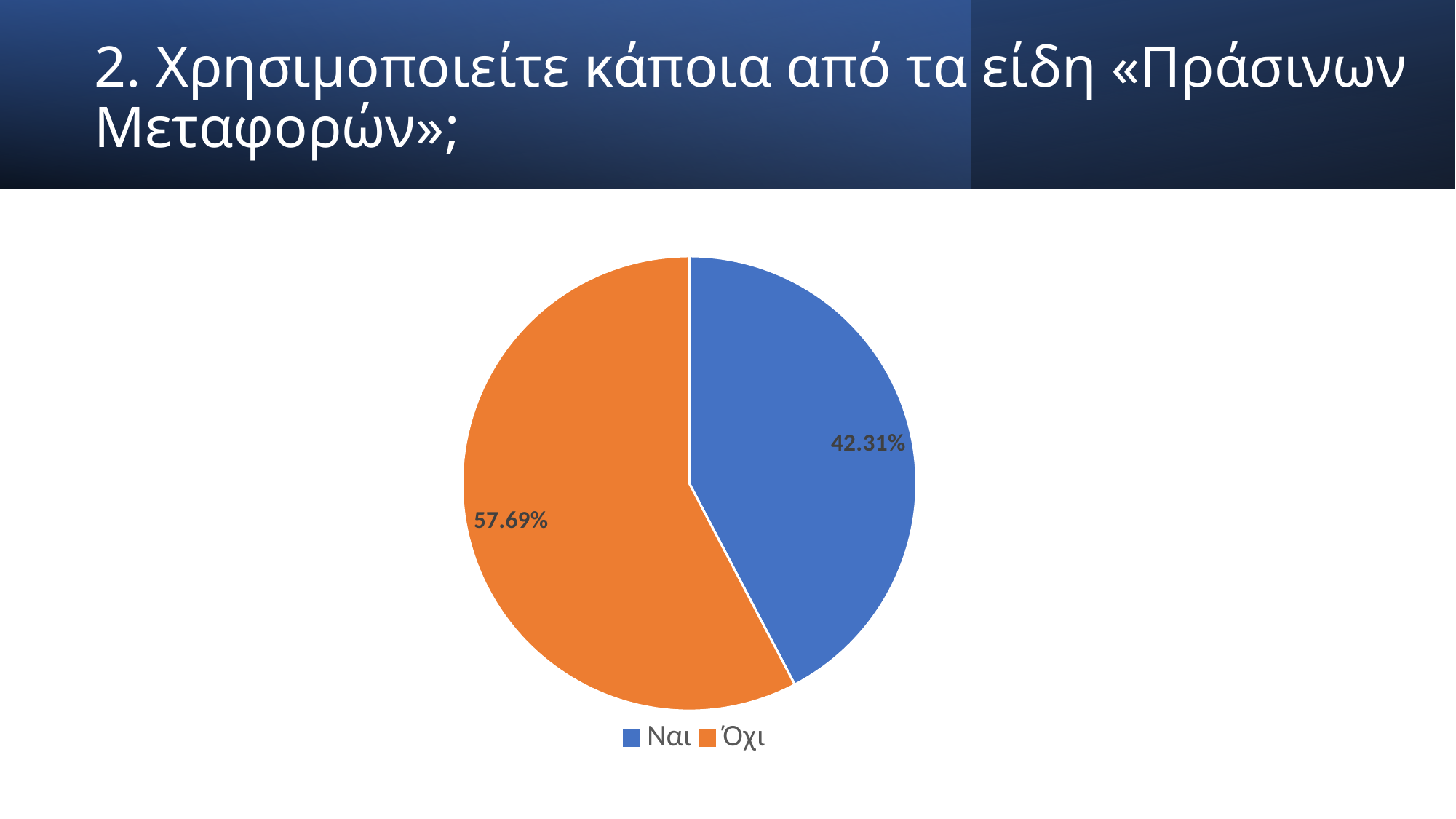
What percentage of the pie is labelled for Ναι? 42.31% What colour is the Ναι slice in the pie chart? blue How many slices does the pie chart have? 2 What kind of chart is shown on the slide? pie chart Which is larger, the Ναι slice or the Όχι slice? Όχι What is the difference in percentage points between the Όχι slice and the Ναι slice? 15.38 What percentage of the pie is labelled for Όχι? 57.69% What colour is the Όχι slice in the pie chart? orange Which slice is the largest in the pie chart? Όχι Which slice is the smallest in the pie chart? Ναι How many entries does the legend list? 2 What share of the pie does the Όχι slice represent? 57.69%